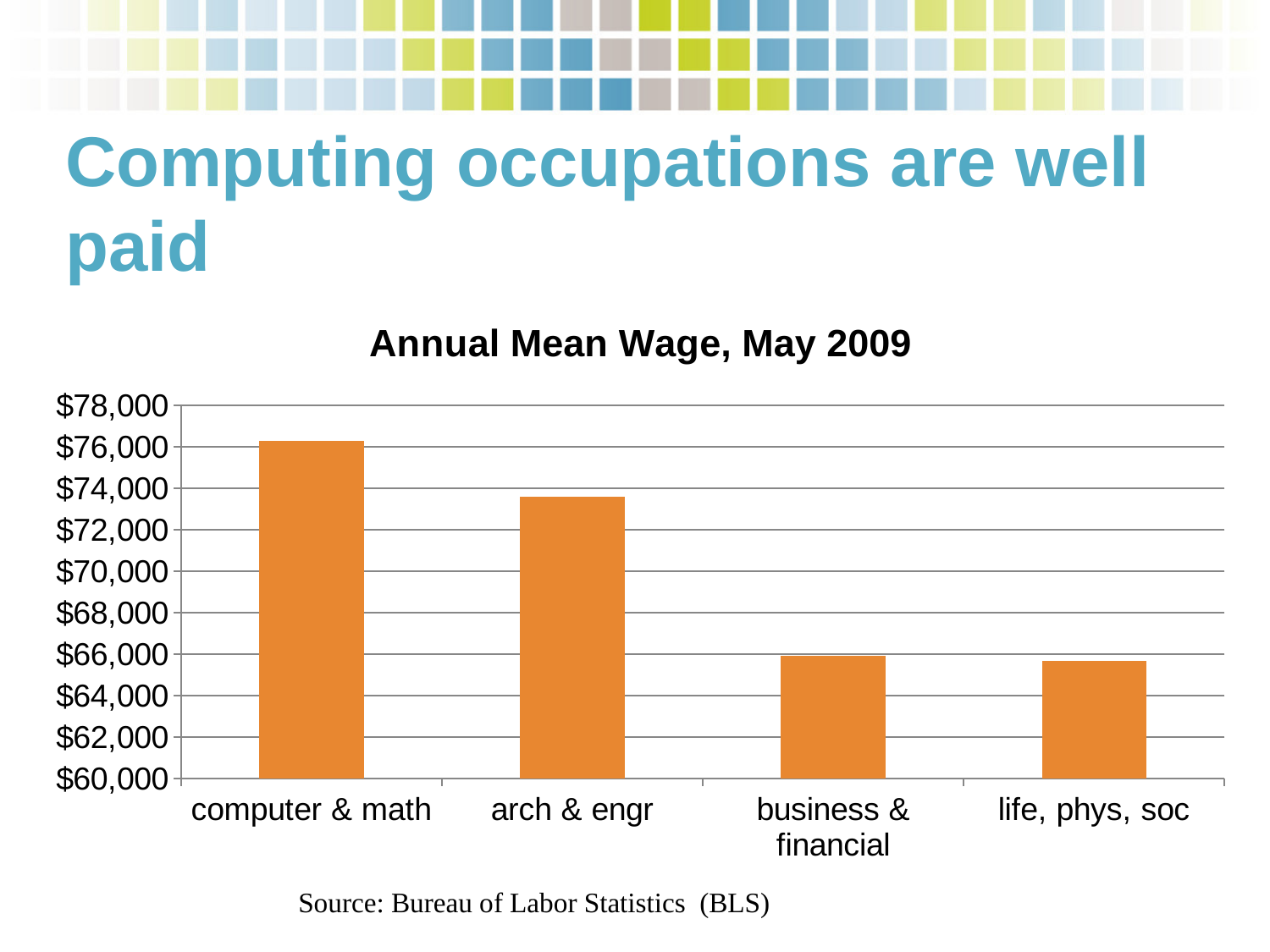
Is the value for business & financial greater or less than $68,000? less Do the bar values rise or fall moving from left to right across the categories? fall How many occupation categories are shown in the chart? 4 Is the value for life, phys, soc greater or less than $64,000? greater What type of chart is shown on the slide? bar chart Which is larger, the annual mean wage for arch & engr or for business & financial? arch & engr Which is larger, the annual mean wage for computer & math or for arch & engr? computer & math Is the value for computer & math greater or less than $74,000? greater What is the title of the chart? Annual Mean Wage, May 2009 Which occupation category has the highest annual mean wage? computer & math